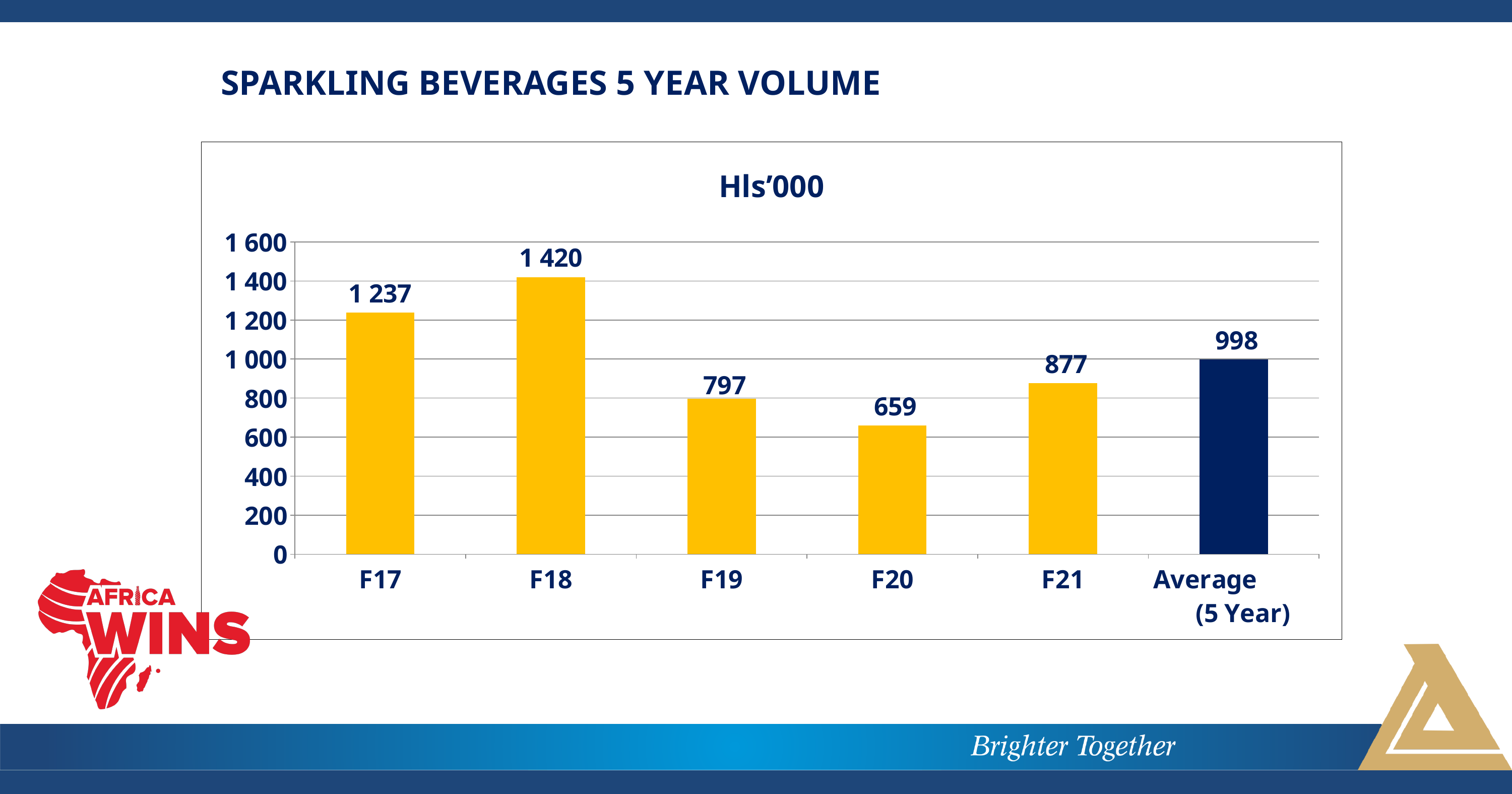
Which year has the highest volume? F18 How many bars are shown in the chart? 6 Which is larger, the volume for F19 or F21? F21 What is the value of the Average (5 Year) bar? 998 Is the value for F17 greater or less than 1 000? greater What is the difference between the F21 and F19 volumes? 80 What is the volume for F18? 1 420 Which year has the lowest volume? F20 What is the volume for F20? 659 What unit label is shown above the chart? Hls'000 What is the difference between the F18 and F17 volumes? 183 What kind of chart is shown on the slide? Bar chart